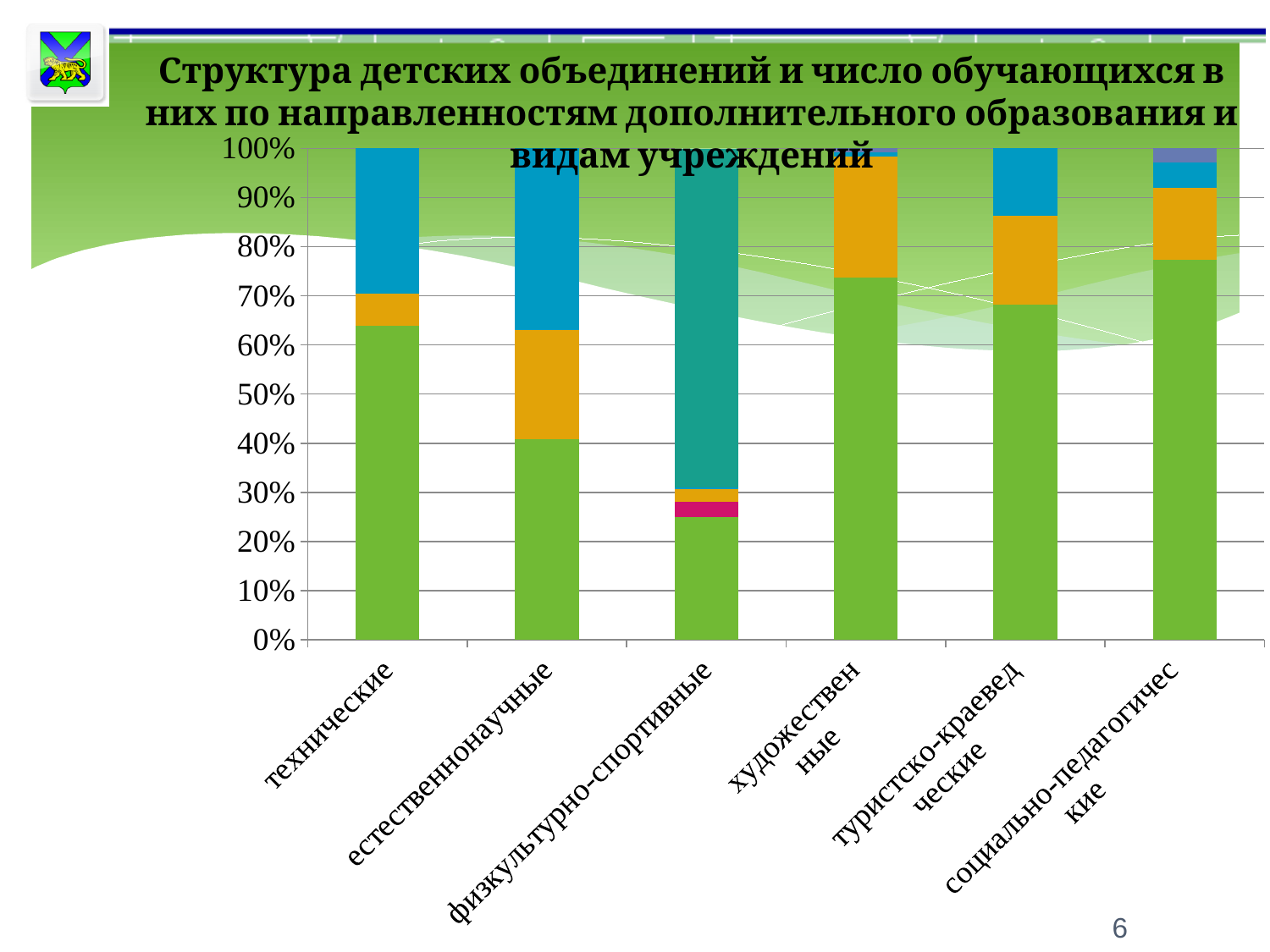
How many categories are shown along the x axis of the chart? 6 Is the green (bottom) segment for технические greater or less than 60%? greater What kind of chart is shown on the slide? Stacked bar chart What is the total height of the stacked bar for технические? 100% Which has the larger light-blue (top) segment: технические or художественные? технические Which has the larger green (bottom) segment: технические or естественнонаучные? технические Is the green (bottom) segment for естественнонаучные greater or less than 50%? less What is the title of the chart on the slide? Структура детских объединений и число обучающихся в них по направленностям дополнительного образования и видам учреждений Is the green (bottom) segment for социально-педагогические greater or less than 70%? greater Which category has the smallest green (bottom) segment? физкультурно-спортивные